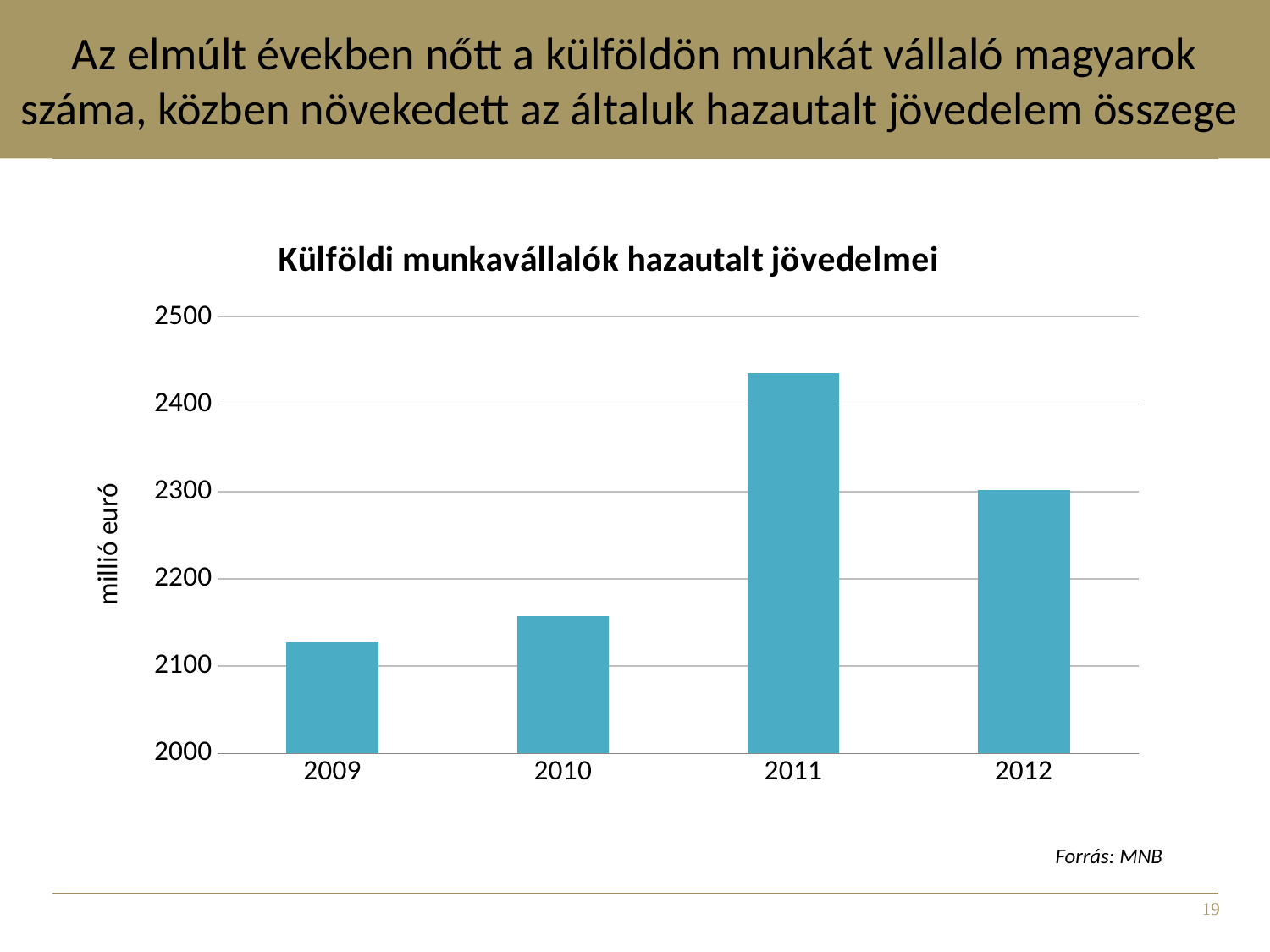
Which year has the lowest value in the chart? 2009 Which is larger, the value for 2011 or the value for 2012? 2011 What kind of chart is shown on the slide? bar chart Do the values rise or fall from 2009 to 2011? rise Is the value for 2012 greater or less than 2400? less What unit is shown on the vertical axis label of the chart? millió euró Is the value for 2009 greater or less than 2200? less Which is larger, the value for 2009 or the value for 2010? 2010 How many years (bars) are shown in the chart? 4 Which year has the highest value in the chart? 2011 What is the title of the chart? Külföldi munkavállalók hazautalt jövedelmei Is the value for 2011 greater or less than 2400? greater